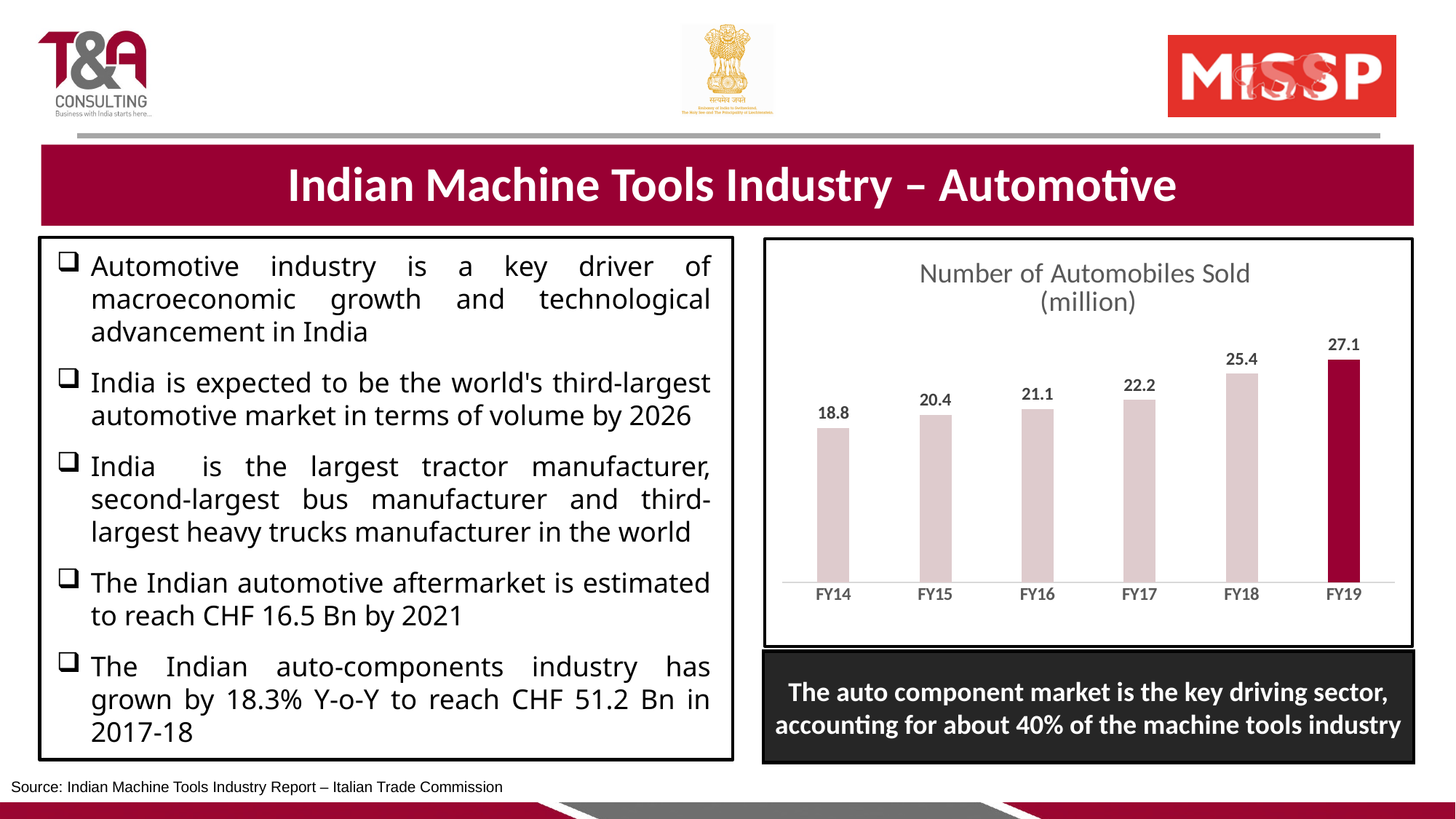
Do the values in the Number of Automobiles Sold chart rise or fall from FY14 to FY19? Rise Which fiscal year has the lowest number of automobiles sold? FY14 What is the value for FY17 in the Number of Automobiles Sold chart? 22.2 What unit is given in the title of the Number of Automobiles Sold chart? million What is the value for FY14 in the Number of Automobiles Sold chart? 18.8 How many fiscal years are shown in the Number of Automobiles Sold chart? 6 Which is larger in the Number of Automobiles Sold chart, FY16 or FY15? FY16 Which fiscal year has the highest number of automobiles sold? FY19 What kind of chart is the Number of Automobiles Sold chart? Bar chart What is the difference between the FY18 and FY17 values in the Number of Automobiles Sold chart? 3.2 What is the difference between the FY19 and FY14 values in the Number of Automobiles Sold chart? 8.3 What is the value for FY19 in the Number of Automobiles Sold chart? 27.1